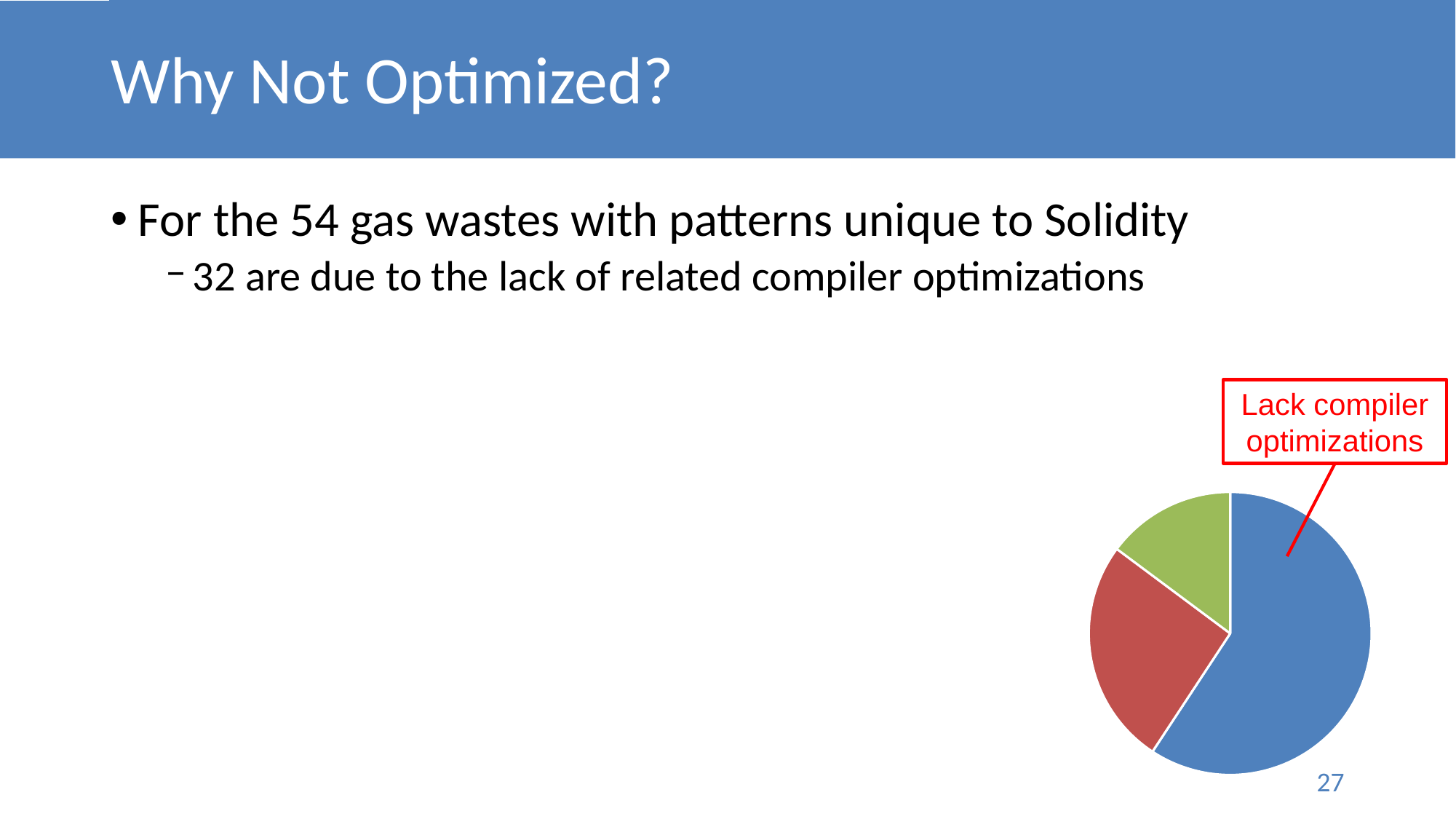
How many slices does the pie chart have? 3 Which slice of the pie chart is the smallest? the green slice Which is larger in the pie chart, the blue slice or the red slice? the blue slice Does the 'Lack compiler optimizations' slice make up more or less than half of the pie? more What label is attached to the blue slice of the pie chart? Lack compiler optimizations What colour is the largest slice of the pie chart? blue Which is larger in the pie chart, the red slice or the green slice? the red slice What kind of chart is shown on the slide? pie chart Which slice of the pie chart is the largest? Lack compiler optimizations